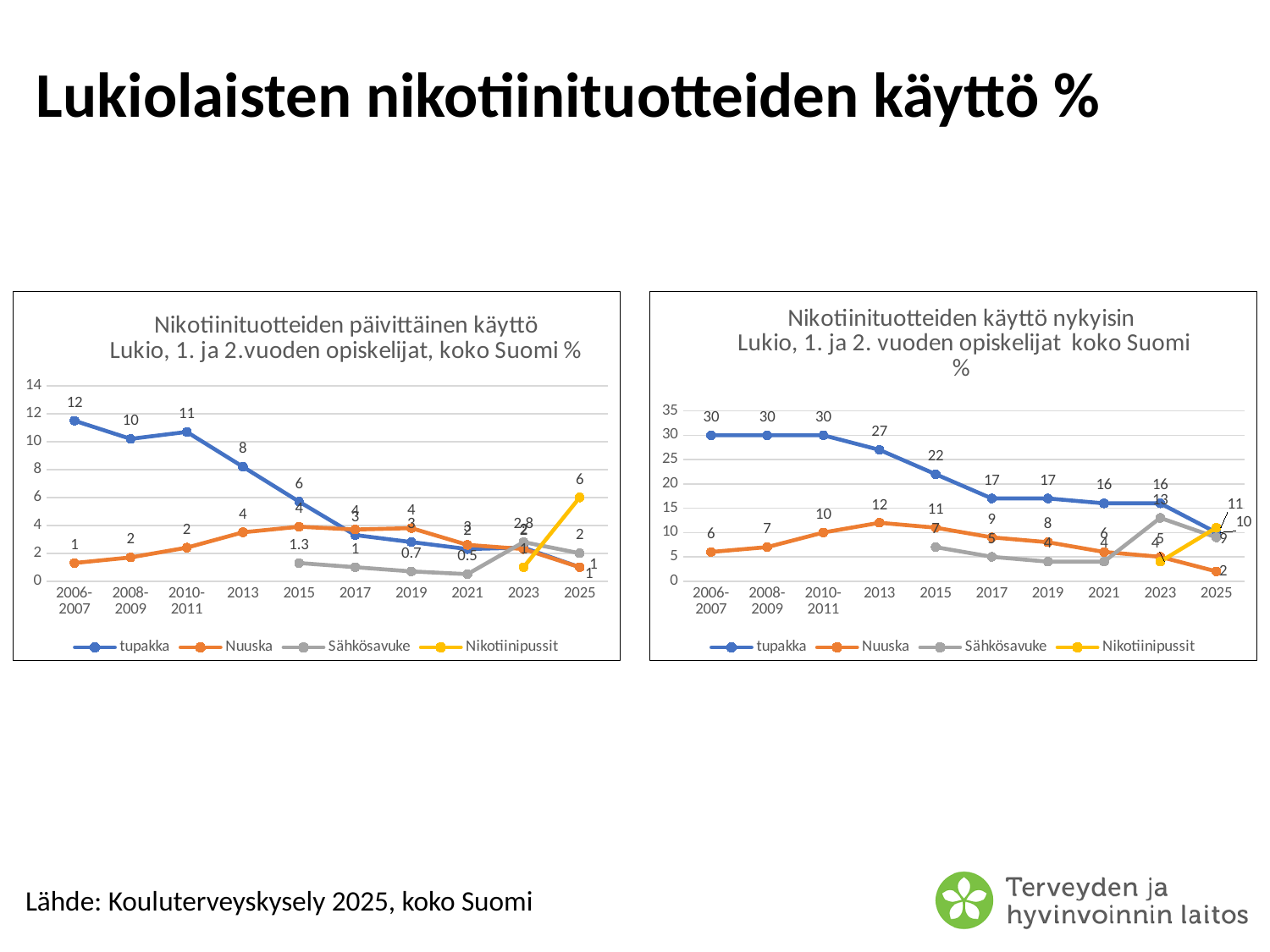
In the right chart (käyttö nykyisin), which is larger in 2015, tupakka or Nuuska? tupakka In the left chart (päivittäinen käyttö), in which period is the tupakka value highest? 2006-2007 What kind of chart is the left chart, 'Nikotiinituotteiden päivittäinen käyttö'? line chart In the right chart (käyttö nykyisin), what is the value for Nuuska in 2013? 12 How many series does the legend of the left chart (päivittäinen käyttö) list? 4 In the left chart (päivittäinen käyttö), what is the value for tupakka in 2006-2007? 12 In the right chart (käyttö nykyisin), what is the value for tupakka in 2013? 27 In the right chart (käyttö nykyisin), what is the value for Sähkösavuke in 2023? 13 In the right chart (käyttö nykyisin), what is the difference between the tupakka value in 2006-2007 and in 2025? 20 In the right chart (käyttö nykyisin), does the tupakka series rise or fall from 2006-2007 to 2025? fall In the left chart (päivittäinen käyttö), what is the value for Nikotiinipussit in 2025? 6 In the left chart (päivittäinen käyttö), what is the value for Sähkösavuke in 2015? 1.3